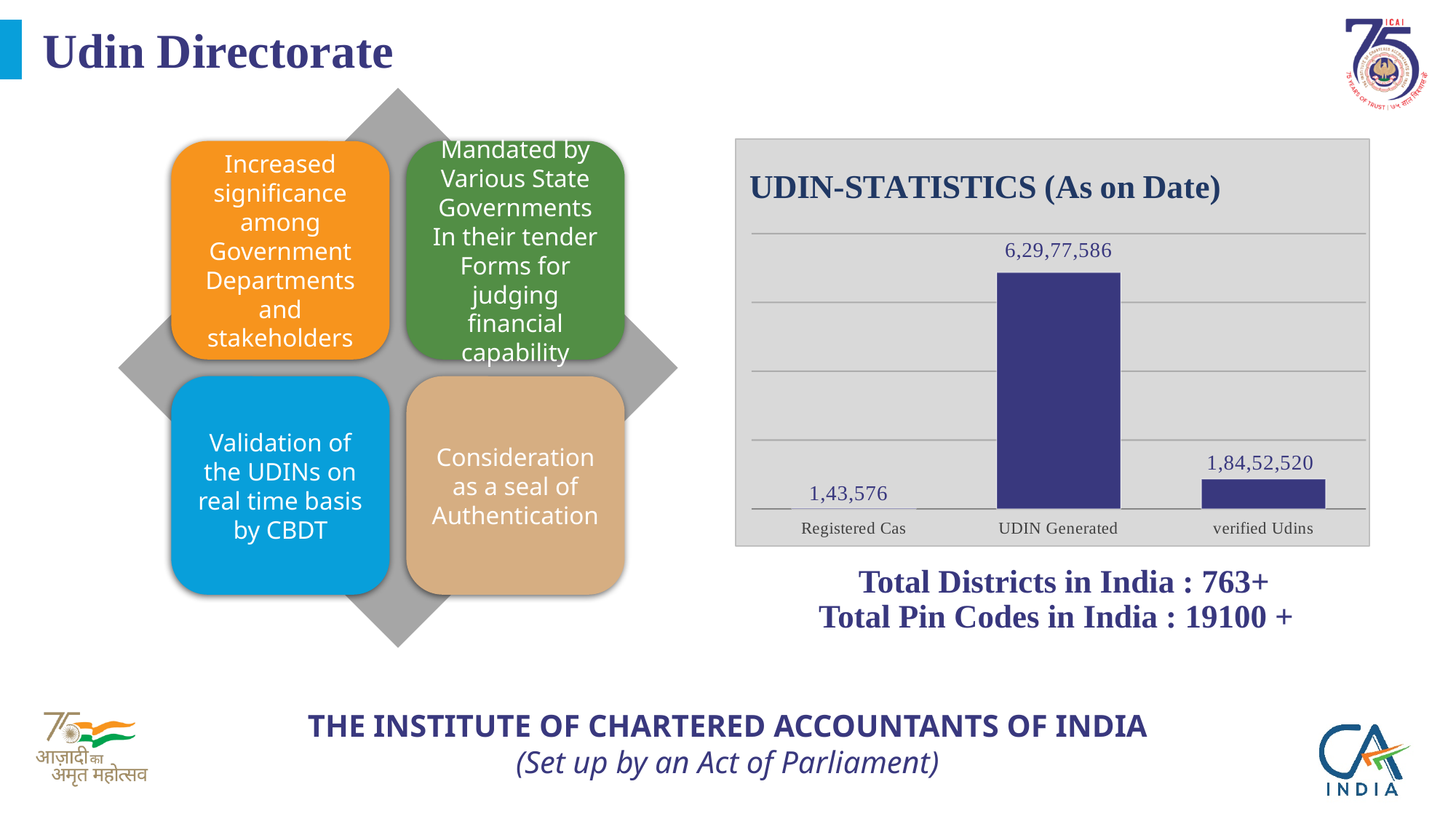
How many categories are shown in the UDIN-STATISTICS chart? 3 What colour are the bars in the UDIN-STATISTICS chart? Dark blue What is the value for UDIN Generated in the UDIN-STATISTICS chart? 6,29,77,586 What is the difference between UDIN Generated and verified Udins in the UDIN-STATISTICS chart? 4,45,25,066 Which is larger in the UDIN-STATISTICS chart: verified Udins or Registered Cas? verified Udins What is the value for verified Udins in the UDIN-STATISTICS chart? 1,84,52,520 What is the value for Registered Cas in the UDIN-STATISTICS chart? 1,43,576 What kind of chart is the UDIN-STATISTICS chart? Bar chart Which category has the highest value in the UDIN-STATISTICS chart? UDIN Generated Which category has the lowest value in the UDIN-STATISTICS chart? Registered Cas What is the difference between verified Udins and Registered Cas in the UDIN-STATISTICS chart? 1,83,08,944 What is the title of the chart on the slide? UDIN-STATISTICS (As on Date)